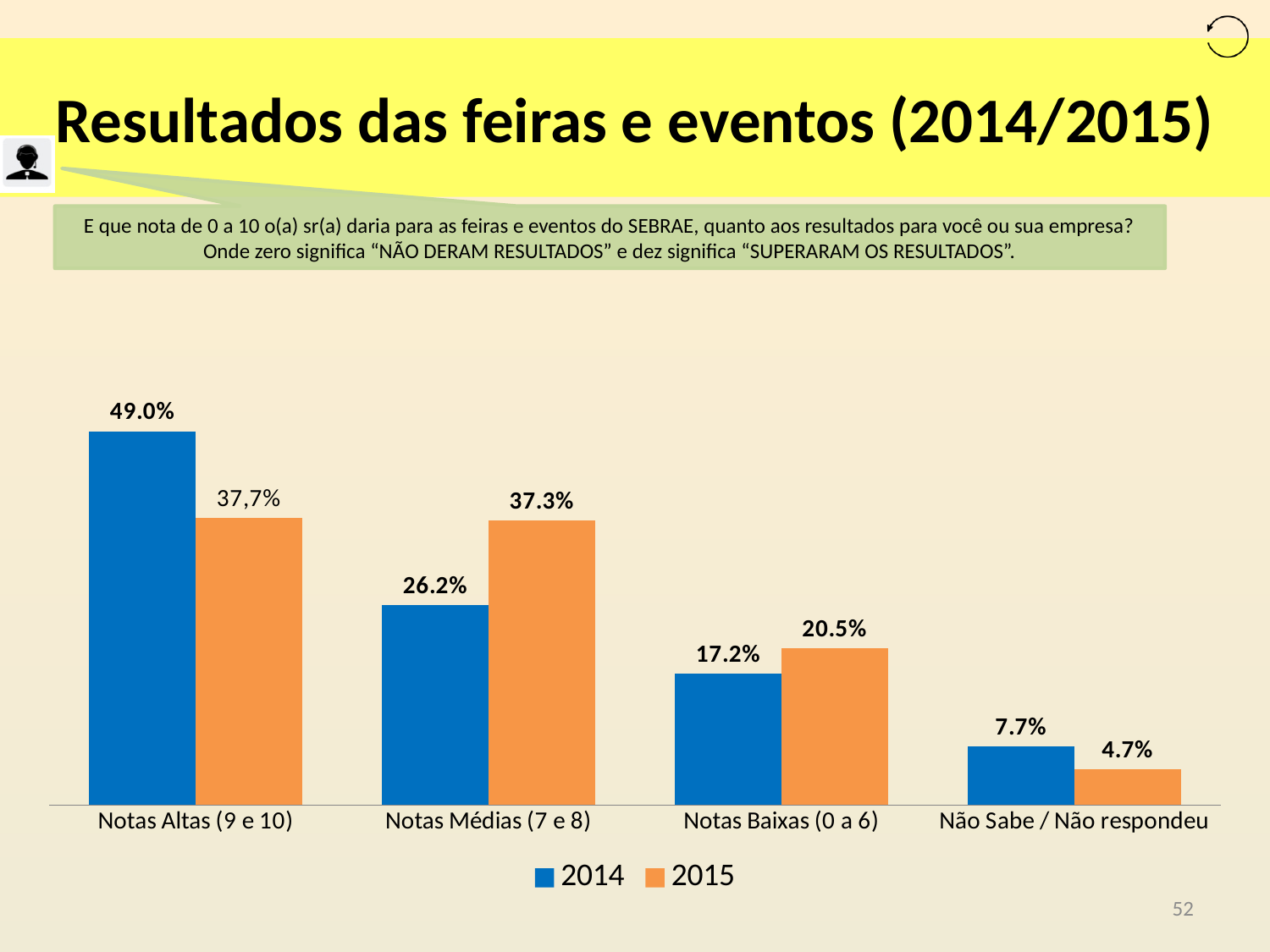
What is the value for Não Sabe / Não respondeu in 2015? 4.7% How many series does the legend list? 2 What is the value for Notas Baixas (0 a 6) in 2014? 17.2% What is the difference between the 2015 and 2014 values for Notas Médias (7 e 8)? 11.1 percentage points What is the value for Notas Altas (9 e 10) in 2015? 37,7% What kind of chart is shown on the slide? Bar chart Which is larger for Notas Baixas (0 a 6): the 2014 value or the 2015 value? 2015 What is the value for Notas Médias (7 e 8) in 2015? 37.3% What is the value for Notas Altas (9 e 10) in 2014? 49.0% How many categories are shown on the x axis? 4 Which category has the lowest value for 2015? Não Sabe / Não respondeu Which category has the highest value for 2014? Notas Altas (9 e 10)